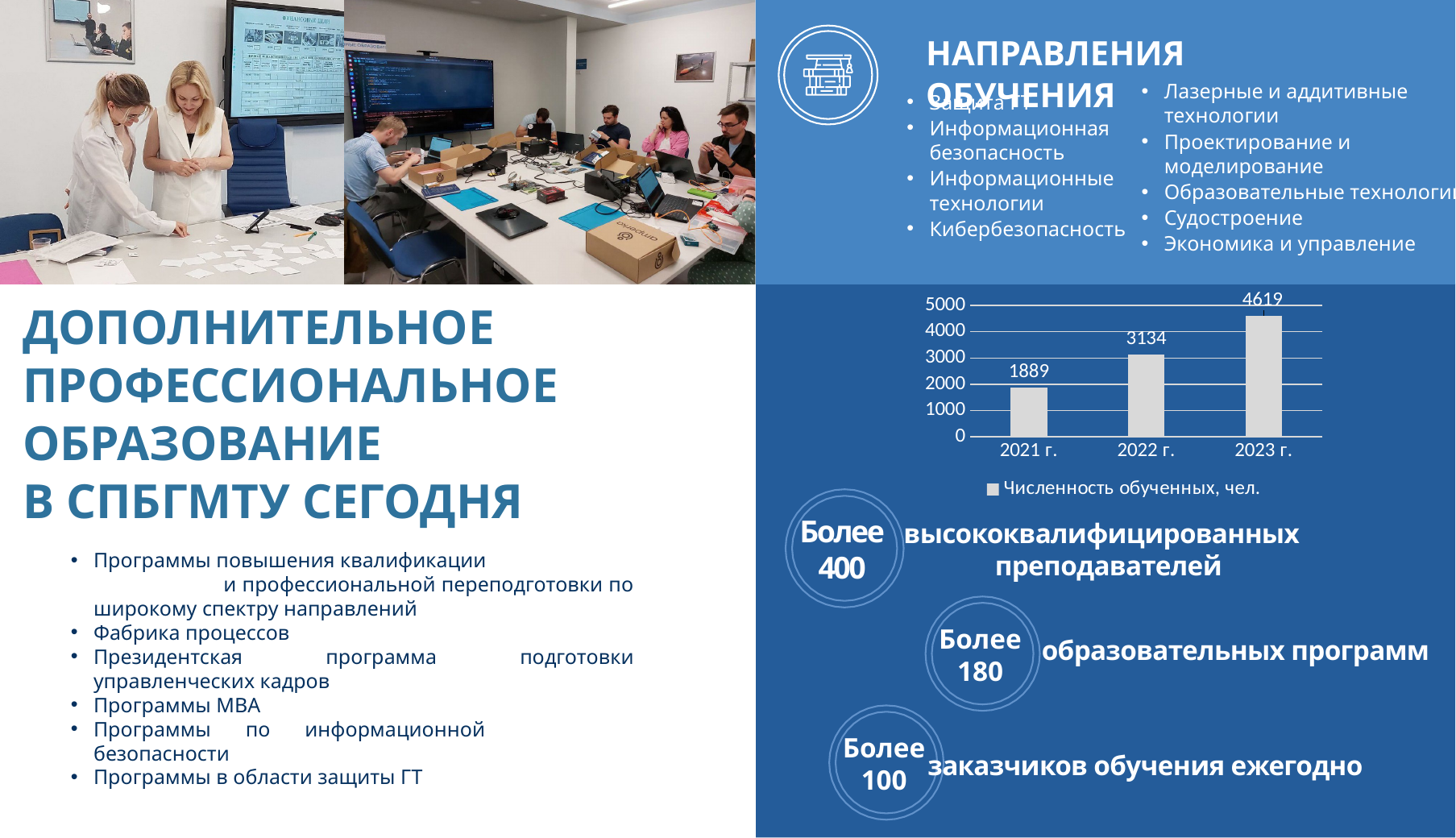
What kind of chart is shown on the slide? bar chart What is the difference between the values for 2022 г. and 2021 г. in the bar chart? 1245 What is the difference between the values for 2023 г. and 2022 г. in the bar chart? 1485 What is the value for 2022 г. in the bar chart? 3134 What is the value for 2021 г. in the bar chart? 1889 Which year has the highest value in the bar chart? 2023 г. Which is larger in the bar chart, the value for 2021 г. or the value for 2022 г.? 2022 г. Is the value for 2023 г. in the bar chart greater or less than 4000? greater How many years are shown in the bar chart? 3 Which year has the lowest value in the bar chart? 2021 г. Do the values in the bar chart rise or fall from 2021 г. to 2023 г.? rise What is the value for 2023 г. in the bar chart? 4619